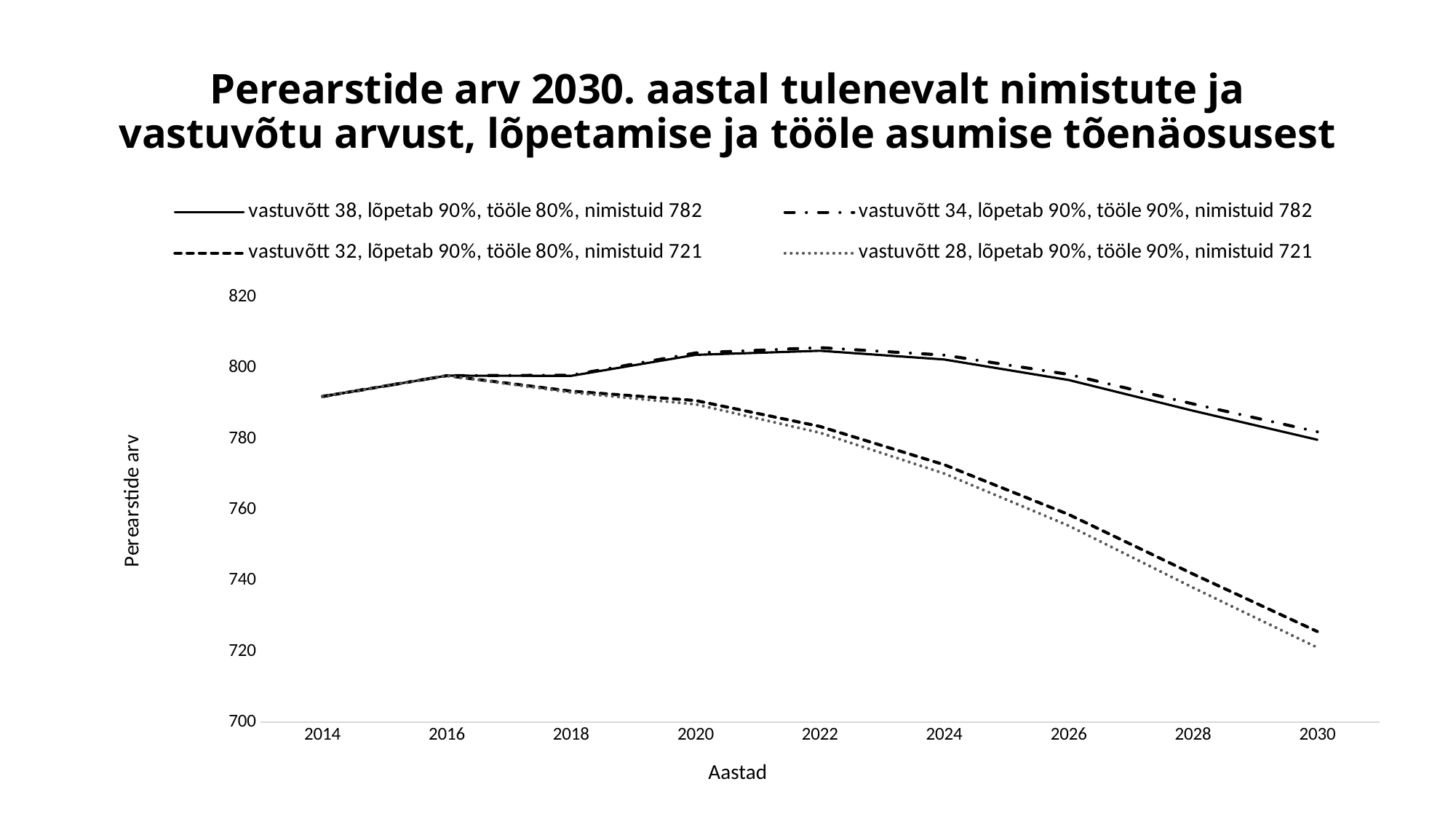
How many year labels are shown on the x axis? 9 How many series does the legend list? 4 What kind of chart is shown on the slide? line chart Does the series 'vastuvõtt 38, lõpetab 90%, tööle 80%, nimistuid 782' rise or fall between 2014 and 2022? rise Is the value for the series 'vastuvõtt 32, lõpetab 90%, tööle 80%, nimistuid 721' in 2030 greater or less than 740? less Is the value for the series 'vastuvõtt 38, lõpetab 90%, tööle 80%, nimistuid 782' in 2022 greater or less than 800? greater Does the series 'vastuvõtt 32, lõpetab 90%, tööle 80%, nimistuid 721' rise or fall between 2016 and 2030? fall Is the value for the series 'vastuvõtt 28, lõpetab 90%, tööle 90%, nimistuid 721' in 2024 greater or less than 780? less In 2030, which is larger: the series 'vastuvõtt 38, lõpetab 90%, tööle 80%, nimistuid 782' or the series 'vastuvõtt 32, lõpetab 90%, tööle 80%, nimistuid 721'? vastuvõtt 38, lõpetab 90%, tööle 80%, nimistuid 782 What is the label of the x axis? Aastad What is the label of the y axis? Perearstide arv